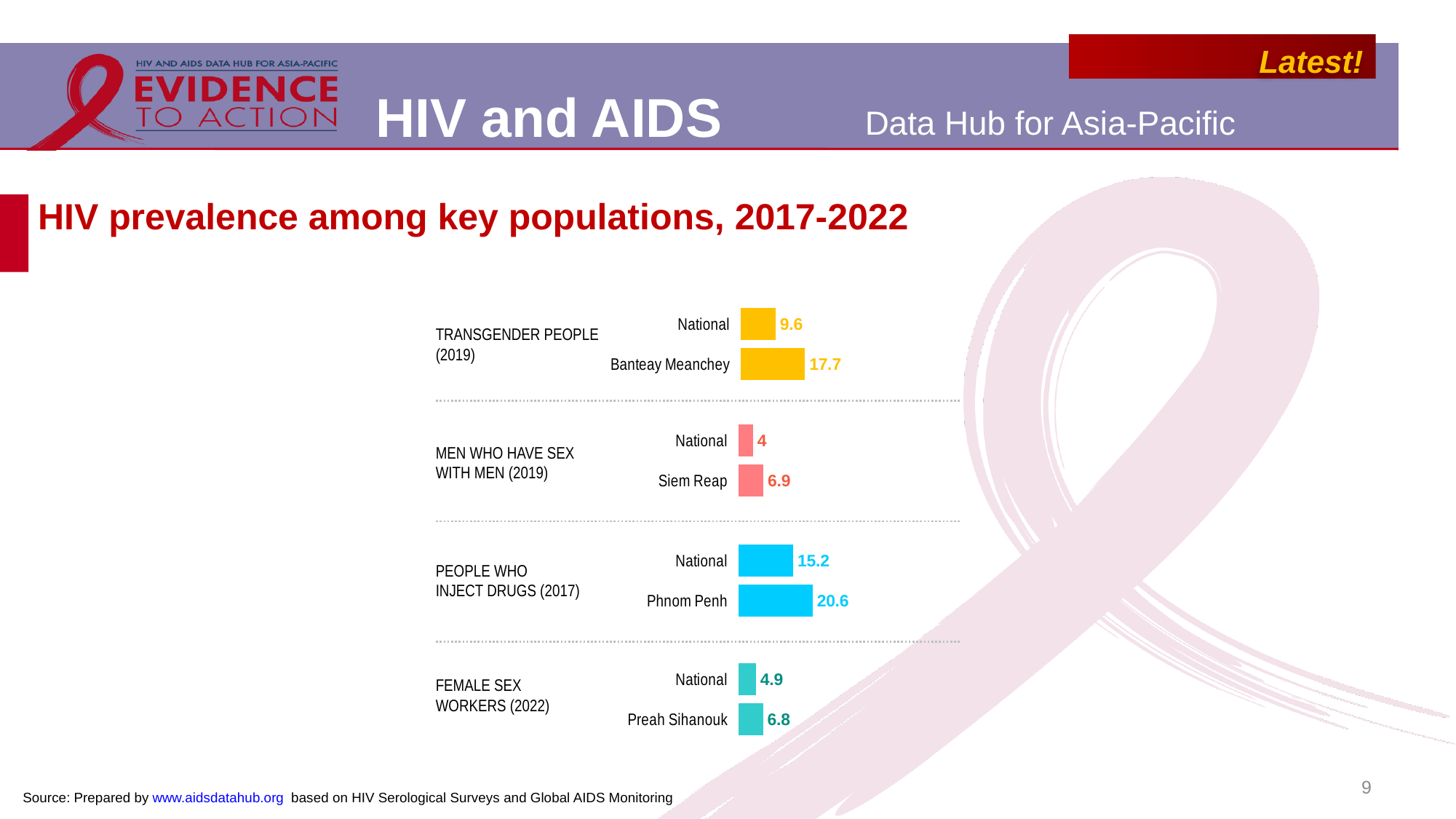
What is the difference between the Phnom Penh and national values for people who inject drugs? 5.4 Which bar has the lowest value on the chart? National (men who have sex with men) What is the title of the chart on the slide? HIV prevalence among key populations, 2017-2022 What is the HIV prevalence value for Phnom Penh among people who inject drugs (2017)? 20.6 What kind of chart is shown on the slide? Bar chart What is the national HIV prevalence value for men who have sex with men (2019)? 4 What is the HIV prevalence value for Banteay Meanchey among transgender people (2019)? 17.7 How many bars are plotted on the chart? 8 What is the HIV prevalence value for Preah Sihanouk among female sex workers (2022)? 6.8 What is the difference between the Banteay Meanchey and national values for transgender people? 8.1 Which bar has the highest value on the chart? Phnom Penh (people who inject drugs) Which is larger: the national value for transgender people or the national value for female sex workers? National value for transgender people